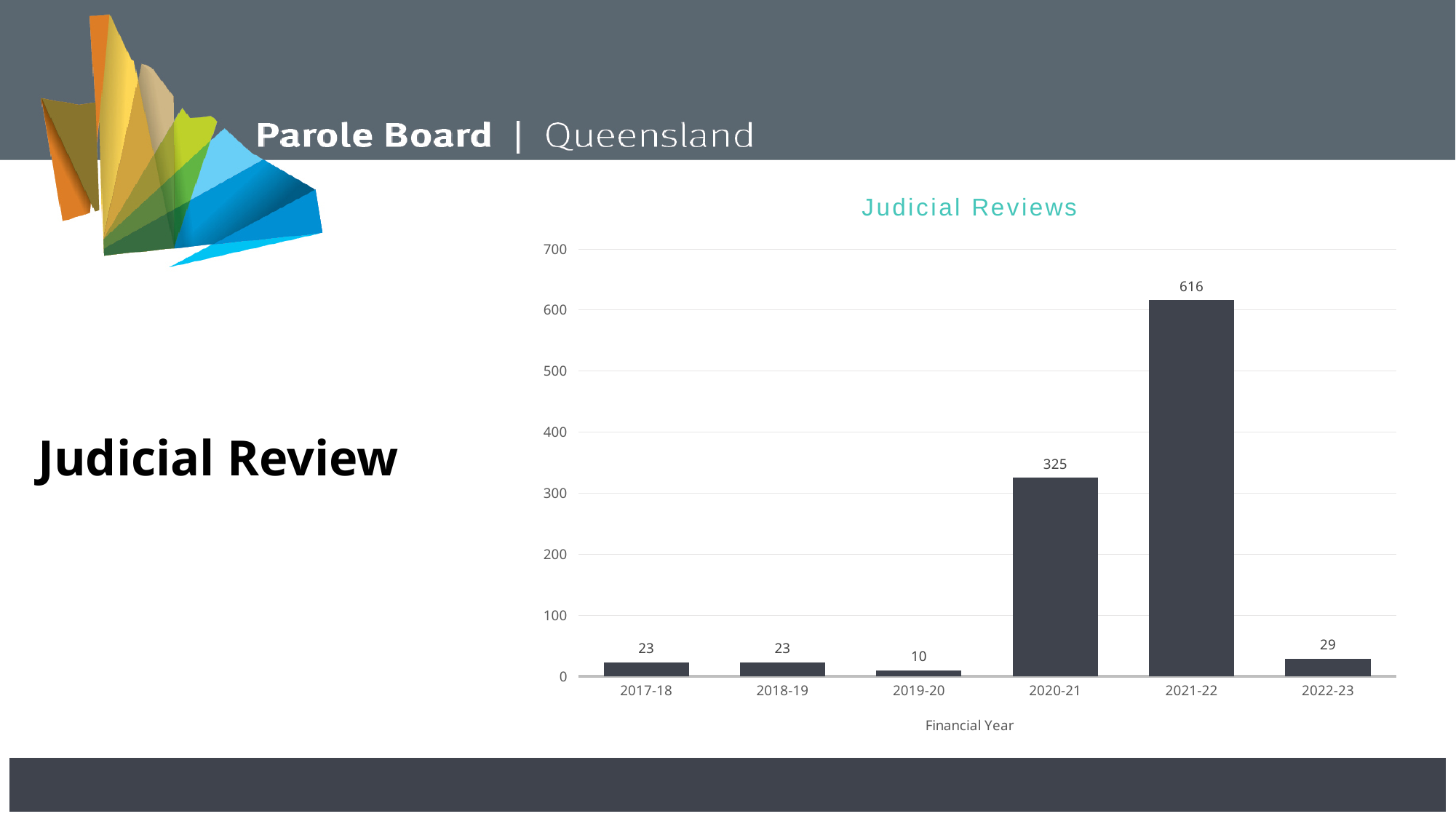
Is the value for 2021-22 greater or less than 600? greater What kind of chart is shown on the slide? Bar chart What is the value for 2020-21 in the Judicial Reviews chart? 325 What is the title of the chart on the slide? Judicial Reviews How many financial years are shown on the x axis of the chart? 6 Which is larger, the value for 2022-23 or the value for 2017-18? 2022-23 Which financial year has the lowest number of judicial reviews? 2019-20 What is the difference between the values for 2021-22 and 2020-21? 291 What is the value for 2019-20 in the Judicial Reviews chart? 10 What is the value for 2021-22 in the Judicial Reviews chart? 616 What is the value for 2022-23 in the Judicial Reviews chart? 29 Which financial year has the highest number of judicial reviews? 2021-22